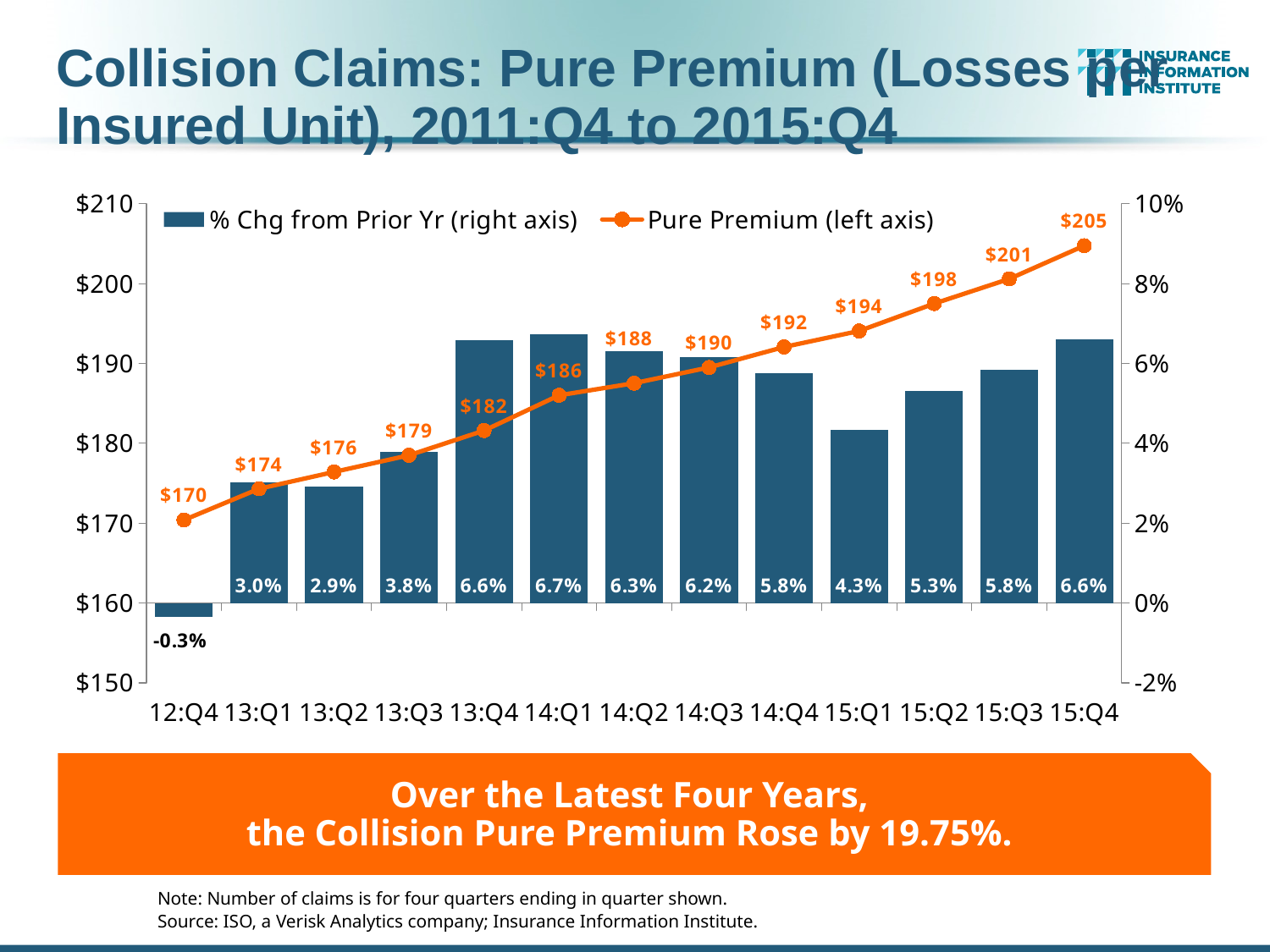
How many quarters are shown on the x axis? 13 What is the difference in Pure Premium between 15:Q4 and 12:Q4? $35 Which quarter has the lowest % Chg from Prior Yr? 12:Q4 How many series does the legend list? 2 What is the % Chg from Prior Yr for 12:Q4? -0.3% Which is larger, the % Chg from Prior Yr for 13:Q4 or for 15:Q1? 13:Q4 What is the Pure Premium value for 14:Q2? $188 Which series is plotted on the right axis according to the legend? % Chg from Prior Yr What is the Pure Premium value for 15:Q4? $205 Does the Pure Premium rise or fall from 12:Q4 to 15:Q4? rise What is the % Chg from Prior Yr for 15:Q1? 4.3% Which quarter has the highest Pure Premium? 15:Q4